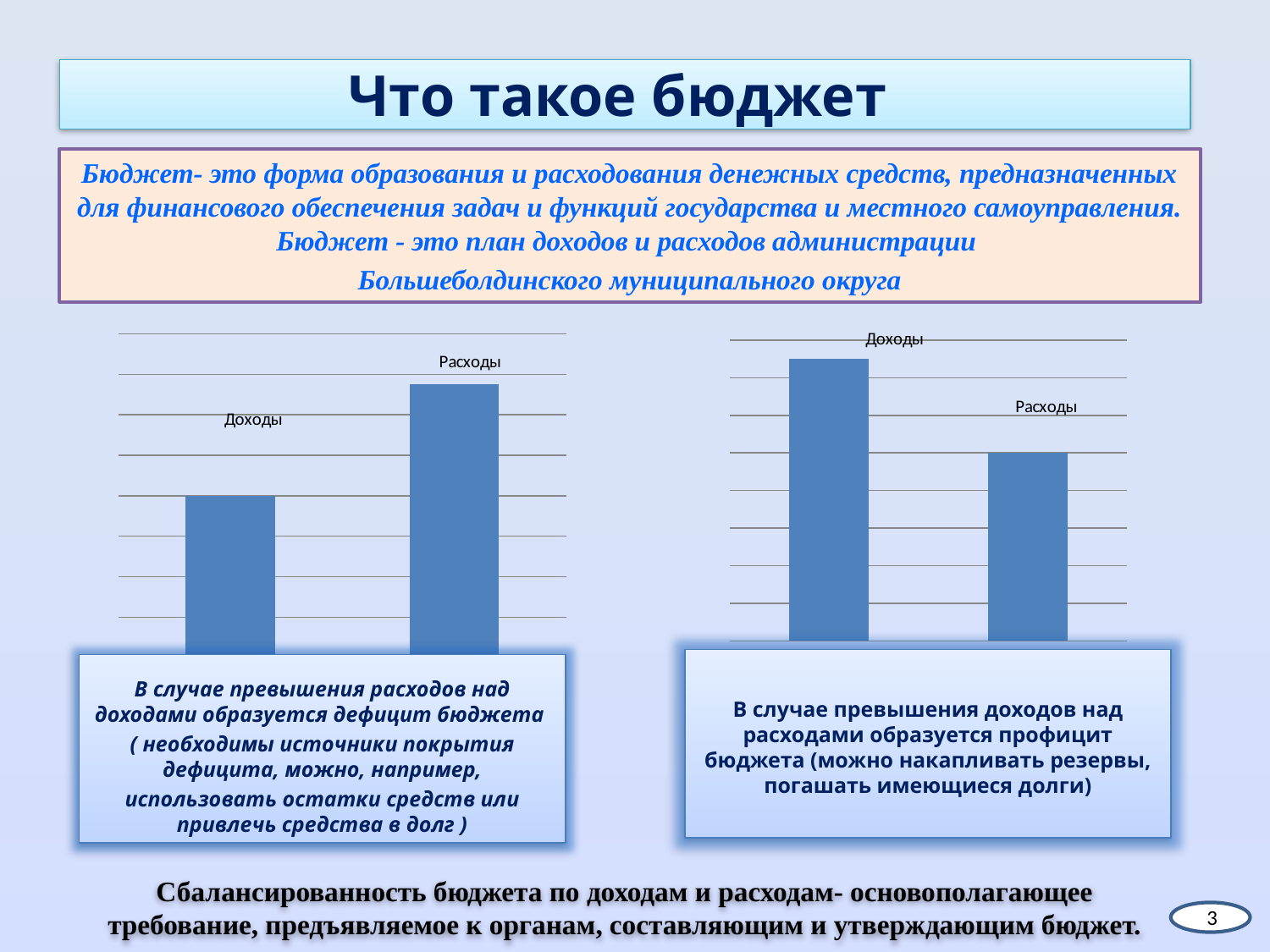
What kind of chart is the chart on the right side of the slide? bar chart How many bars does the chart on the left side of the slide have? 2 In the chart on the right side of the slide, which bar is the tallest? Доходы In the chart on the right side of the slide, which bar is the shortest? Расходы In the chart on the left side of the slide, which bar is the tallest? Расходы In the chart on the right side of the slide, is the bar for Доходы taller or shorter than the bar for Расходы? taller In the chart on the left side of the slide, which bar is the shortest? Доходы What colour are the bars in the chart on the right side of the slide? blue What are the labels of the two bars in the chart on the left side of the slide? Доходы and Расходы How many bars does the chart on the right side of the slide have? 2 What kind of chart is the chart on the left side of the slide? bar chart In the chart on the left side of the slide, is the bar for Доходы taller or shorter than the bar for Расходы? shorter